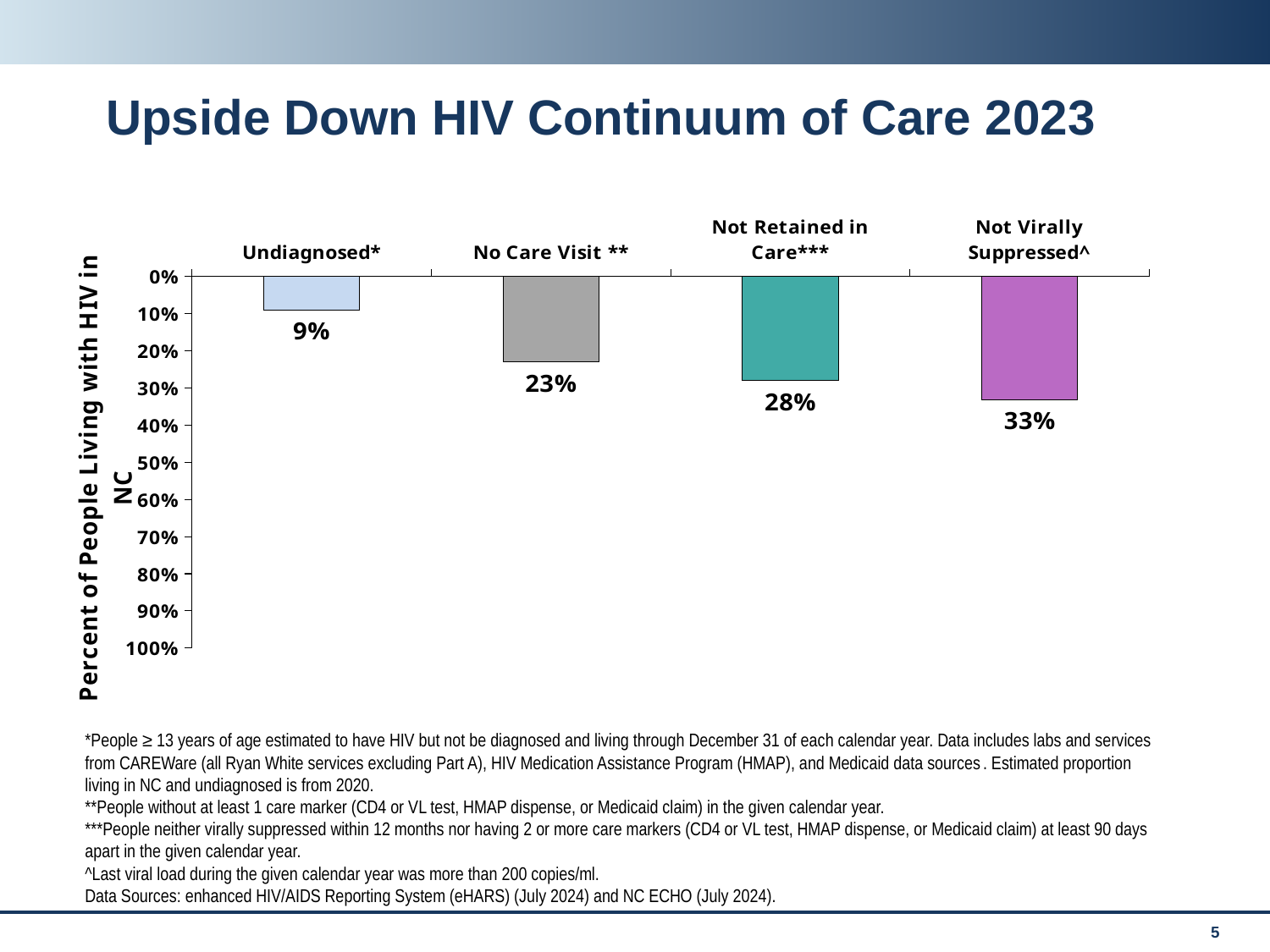
What is the value for No Care Visit **? 23% What is the difference between the values for Not Retained in Care*** and No Care Visit **? 5% Which category has the lowest value? Undiagnosed* How many categories are shown in the chart? 4 What is the value for Not Retained in Care***? 28% What kind of chart is shown on the slide? Bar chart What is the difference between the values for Not Virally Suppressed^ and Undiagnosed*? 24% What is the value for Undiagnosed*? 9% Which is larger, the value for No Care Visit ** or the value for Not Retained in Care***? Not Retained in Care*** What is the label of the vertical axis? Percent of People Living with HIV in NC What is the value for Not Virally Suppressed^? 33% Which category has the highest value? Not Virally Suppressed^